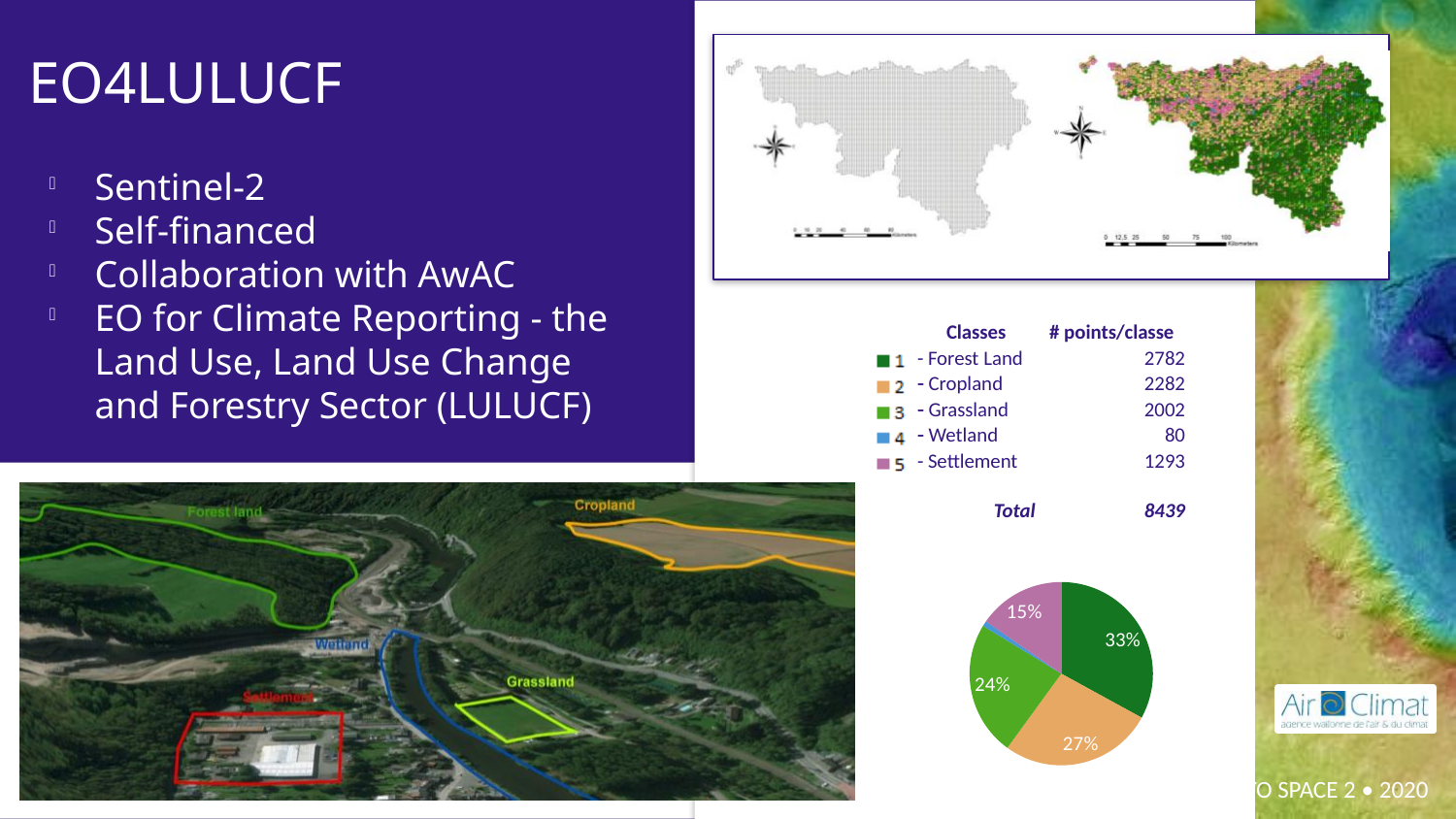
What is the difference in points between Forest Land and Cropland in the class table? 500 What kind of chart is shown below the class table on the right side of the slide? pie chart How many classes are listed in the legend of the class table? 5 Which class has the lowest number of points in the class table? Wetland In the pie chart, what share is shown for the largest slice (dark green, Forest Land)? 33% According to the class table, how many points per class are listed for Wetland? 80 What is the total number of points across all classes shown in the table? 8439 In the pie chart, what share is shown for the tan Cropland slice? 27% Which class has the highest number of points in the class table? Forest Land In the pie chart, what share is shown for the purple Settlement slice? 15% According to the class table, how many points per class are listed for Cropland? 2282